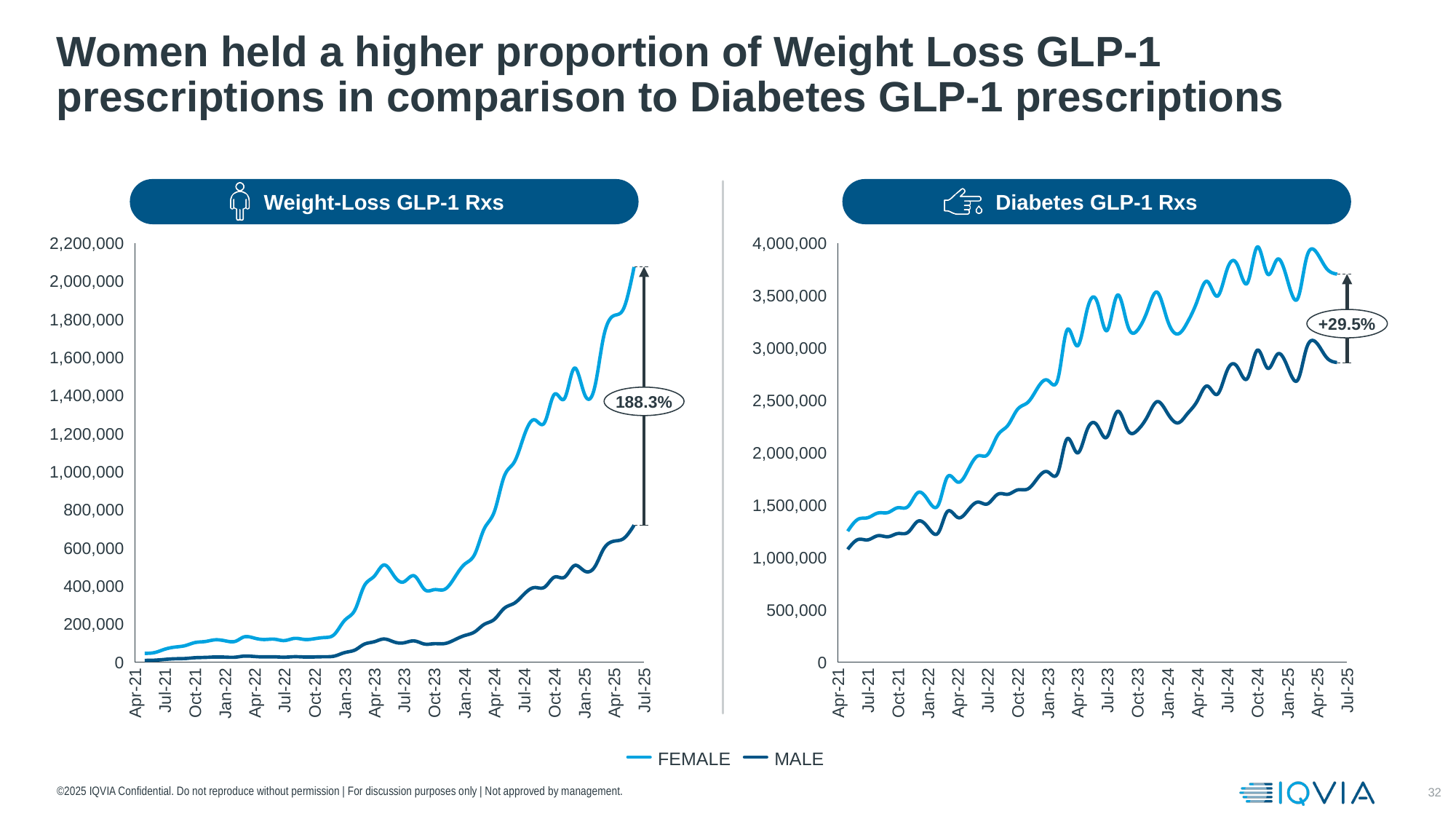
What kind of chart is the Weight-Loss GLP-1 Rxs chart? line chart In the Diabetes GLP-1 Rxs chart, which series is higher at Jan-24, FEMALE or MALE? FEMALE In the Weight-Loss GLP-1 Rxs chart, is the FEMALE value at Jul-25 greater or less than 1,800,000? greater In the Diabetes GLP-1 Rxs chart, does the MALE series generally rise or fall from Apr-21 to Jul-25? rise In the Diabetes GLP-1 Rxs chart, is the FEMALE value at Oct-24 greater or less than 3,500,000? greater What percentage is shown in the annotation on the Weight-Loss GLP-1 Rxs chart? 188.3% In the Diabetes GLP-1 Rxs chart, is the MALE value at Apr-21 greater or less than 1,500,000? less In the Weight-Loss GLP-1 Rxs chart, does the FEMALE series generally rise or fall from Apr-21 to Jul-25? rise How many series does the legend list for the charts? 2 What percentage is shown in the annotation on the Diabetes GLP-1 Rxs chart? +29.5% In the Weight-Loss GLP-1 Rxs chart, which series is higher at Jul-25, FEMALE or MALE? FEMALE